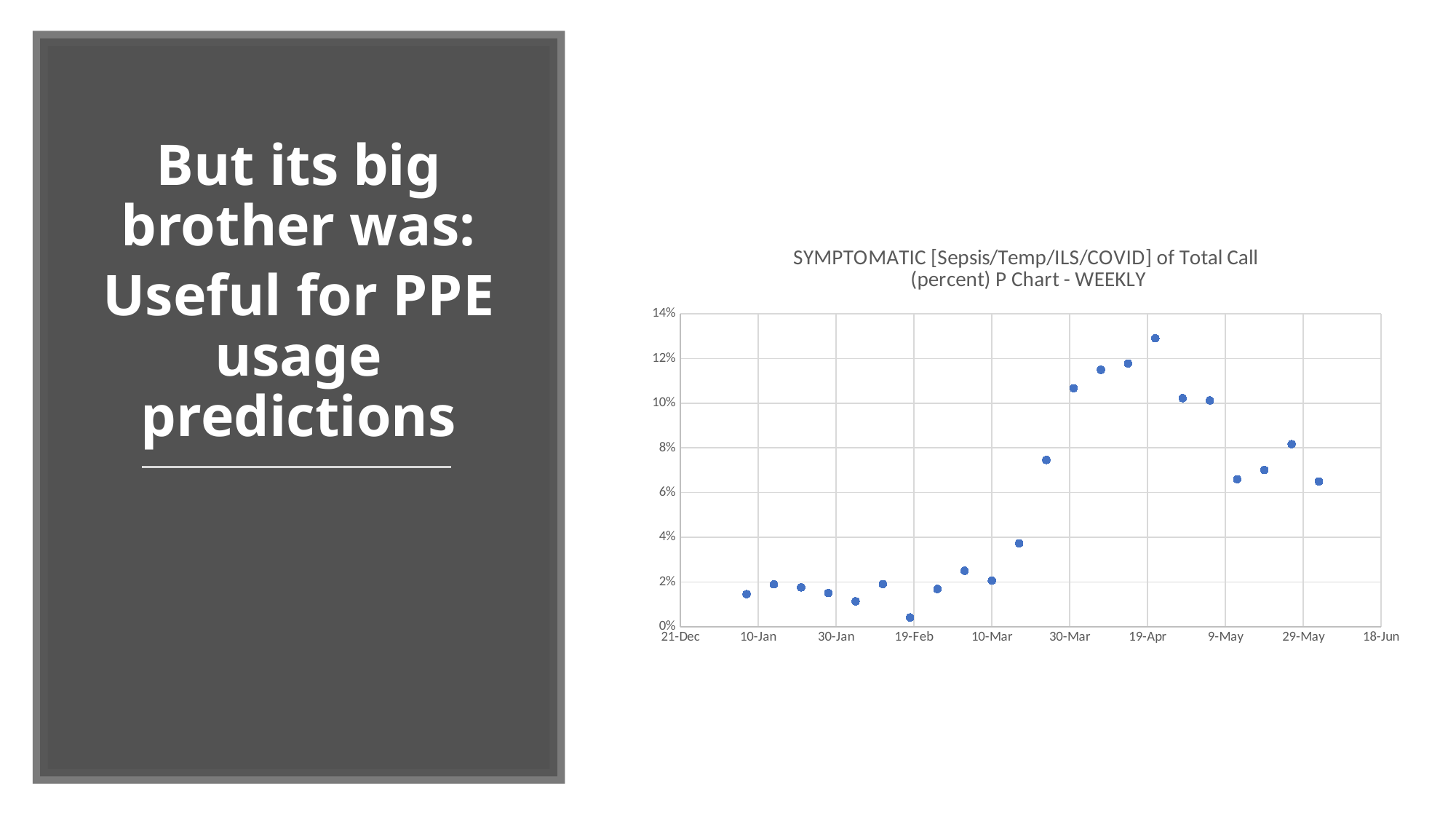
What is the title of the chart? SYMPTOMATIC [Sepsis/Temp/ILS/COVID] of Total Call (percent) P Chart - WEEKLY Is the value of the point at 30-Mar greater or less than 10%? greater Is the value of the point at 10-Mar greater or less than 4%? less Around which x-axis date does the lowest point on the chart occur? 19-Feb Is the value of the point at 19-Apr greater or less than 12%? greater What is the highest value shown on the y axis? 14% Which point has the larger value, the one at 19-Apr or the one at 9-May? 19-Apr What kind of chart is shown on the slide? Scatter chart Around which x-axis date does the highest point on the chart occur? 19-Apr Do the values rise or fall between 10-Mar and 19-Apr? rise